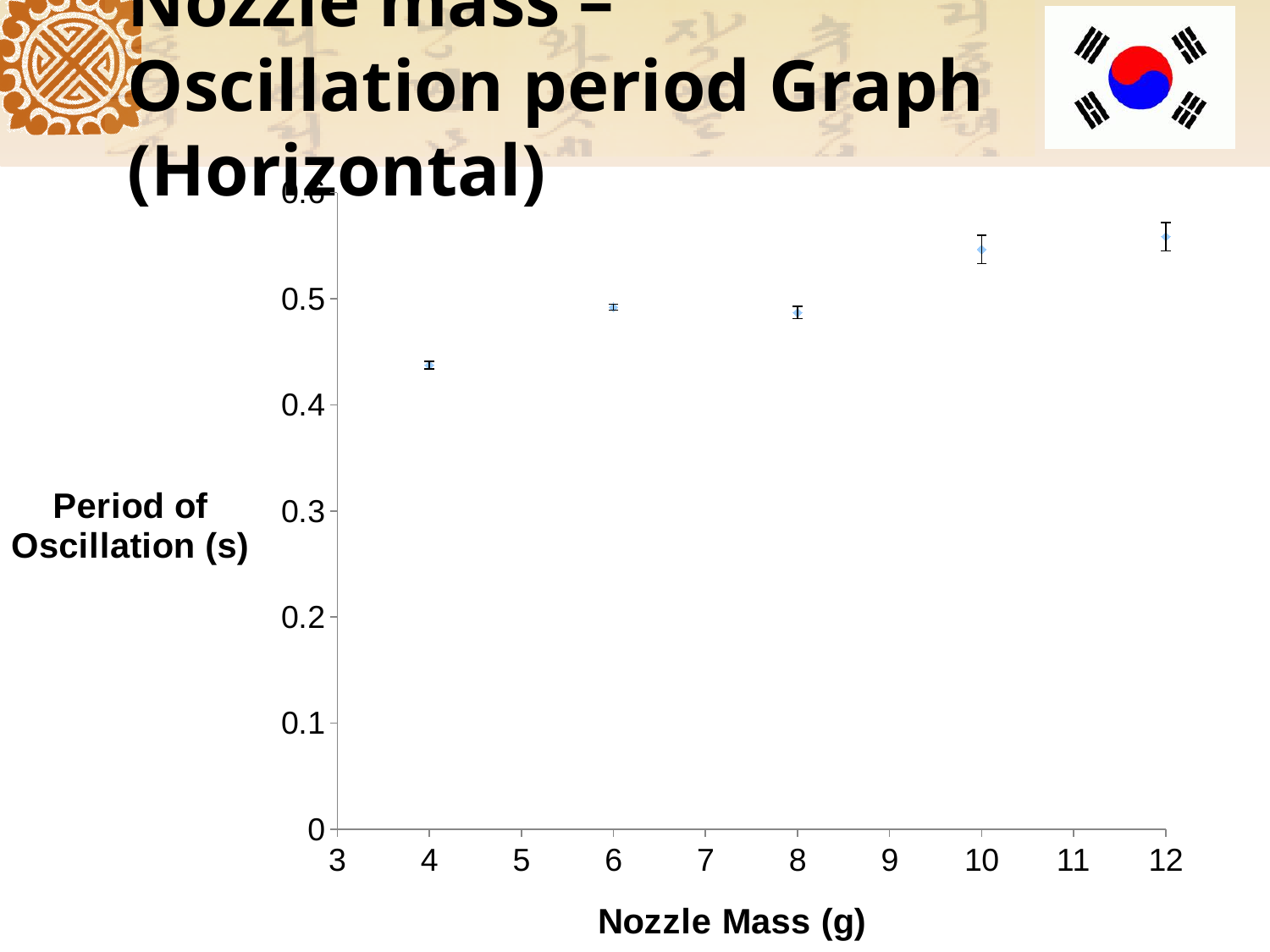
How many data points are plotted on the chart? 5 Which has a larger period of oscillation: a nozzle mass of 6 g or 12 g? 12 g What is the label of the y axis? Period of Oscillation (s) Is the period of oscillation for a nozzle mass of 4 g greater or less than 0.5 s? less Is the period of oscillation for a nozzle mass of 12 g greater or less than 0.5 s? greater Is the period of oscillation for a nozzle mass of 4 g greater or less than 0.4 s? greater Which nozzle mass has the lowest period of oscillation? 4 g Which has a larger period of oscillation: a nozzle mass of 4 g or 10 g? 10 g What kind of chart is shown on the slide? Scatter plot Does the period of oscillation generally rise or fall as nozzle mass increases? Rise What is the label of the x axis? Nozzle Mass (g)